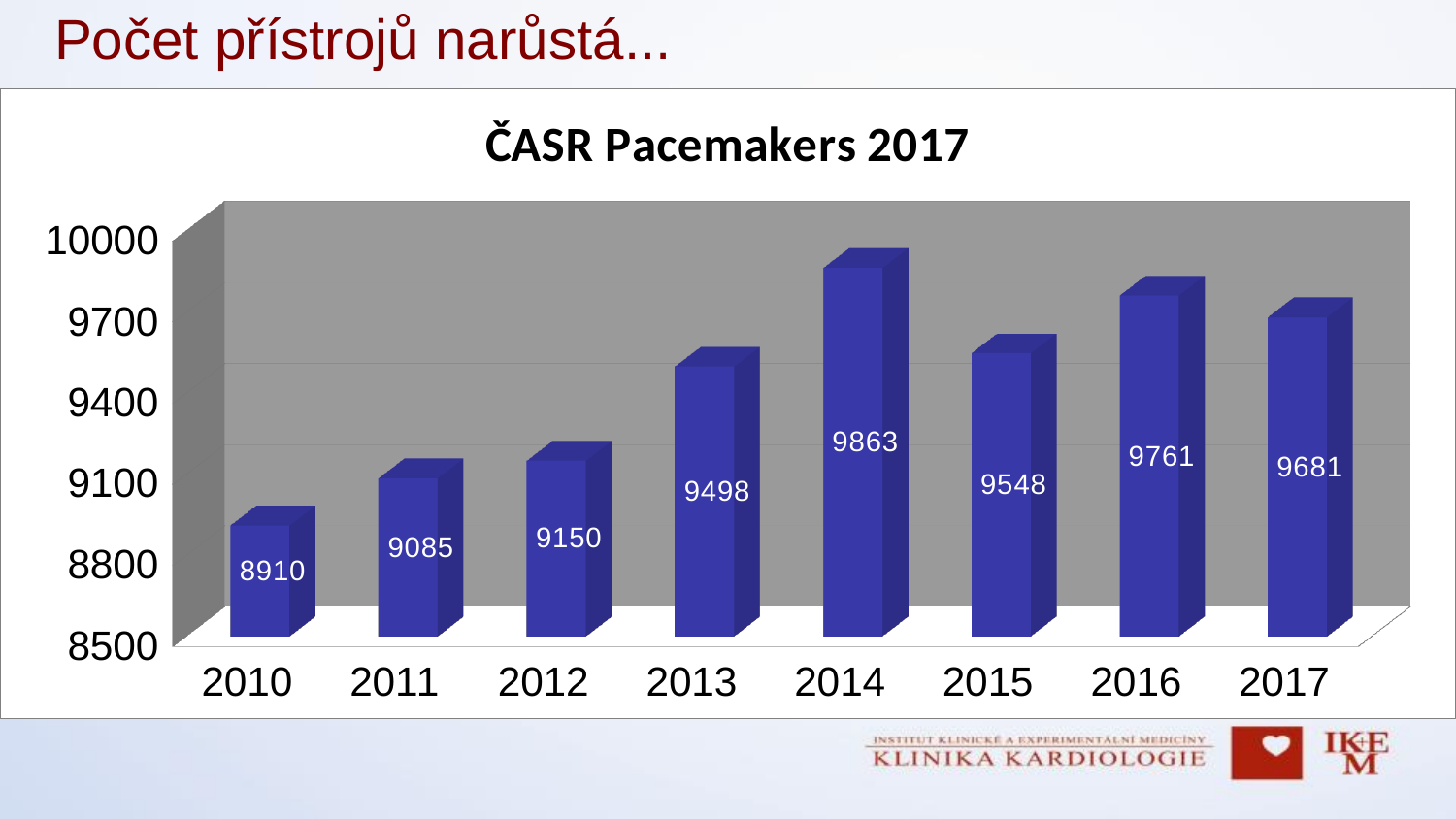
Which year has the highest value? 2014 Which is larger, the value for 2015 or the value for 2013? 2015 What is the title of the chart? ČASR Pacemakers 2017 What is the value for 2014? 9863 Is the value for 2012 greater or less than 9400? less How many years are shown on the x axis? 8 What is the value for 2017? 9681 Which year has the lowest value? 2010 What kind of chart is shown? bar chart What is the difference between the values for 2016 and 2017? 80 What is the value for 2010? 8910 What is the difference between the values for 2014 and 2010? 953